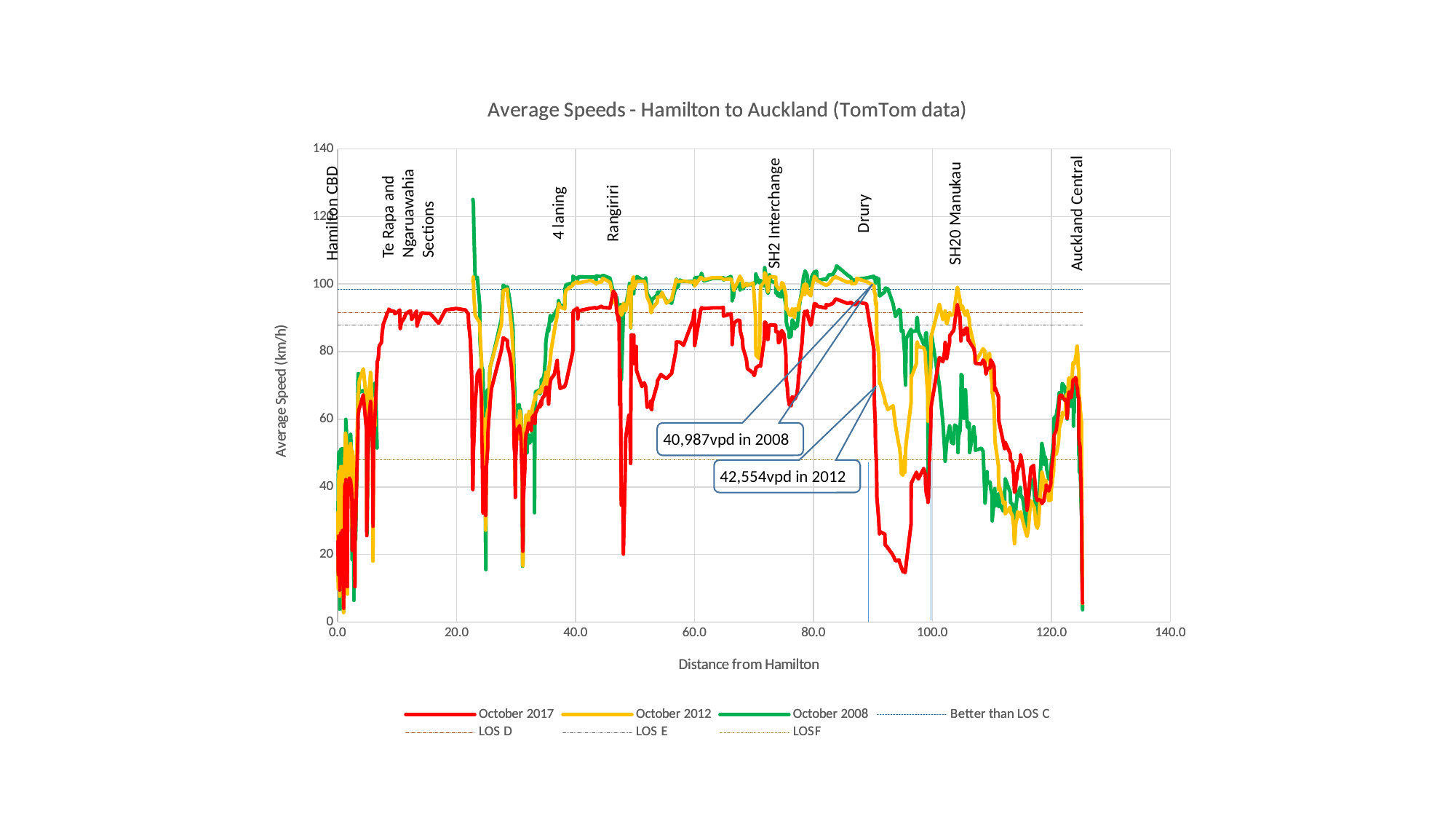
What traffic volume does the annotation give for 2012? 42,554vpd How many entries does the chart's legend list? 7 Is the October 2017 average speed at about 95 km from Hamilton greater or less than 40? less Which series has the lowest average speed at about 95 km from Hamilton? October 2017 What type of chart is shown on the slide? Line chart What is the title of the chart? Average Speeds - Hamilton to Auckland (TomTom data) What is the label of the vertical axis? Average Speed (km/h) Is the October 2008 average speed at about 60 km from Hamilton greater or less than 80? greater At about 95 km from Hamilton, which series has the higher average speed, October 2008 or October 2017? October 2008 What traffic volume does the annotation give for 2008? 40,987vpd What is the highest value shown on the vertical axis? 140 How many October data series (years) are plotted on the chart? 3